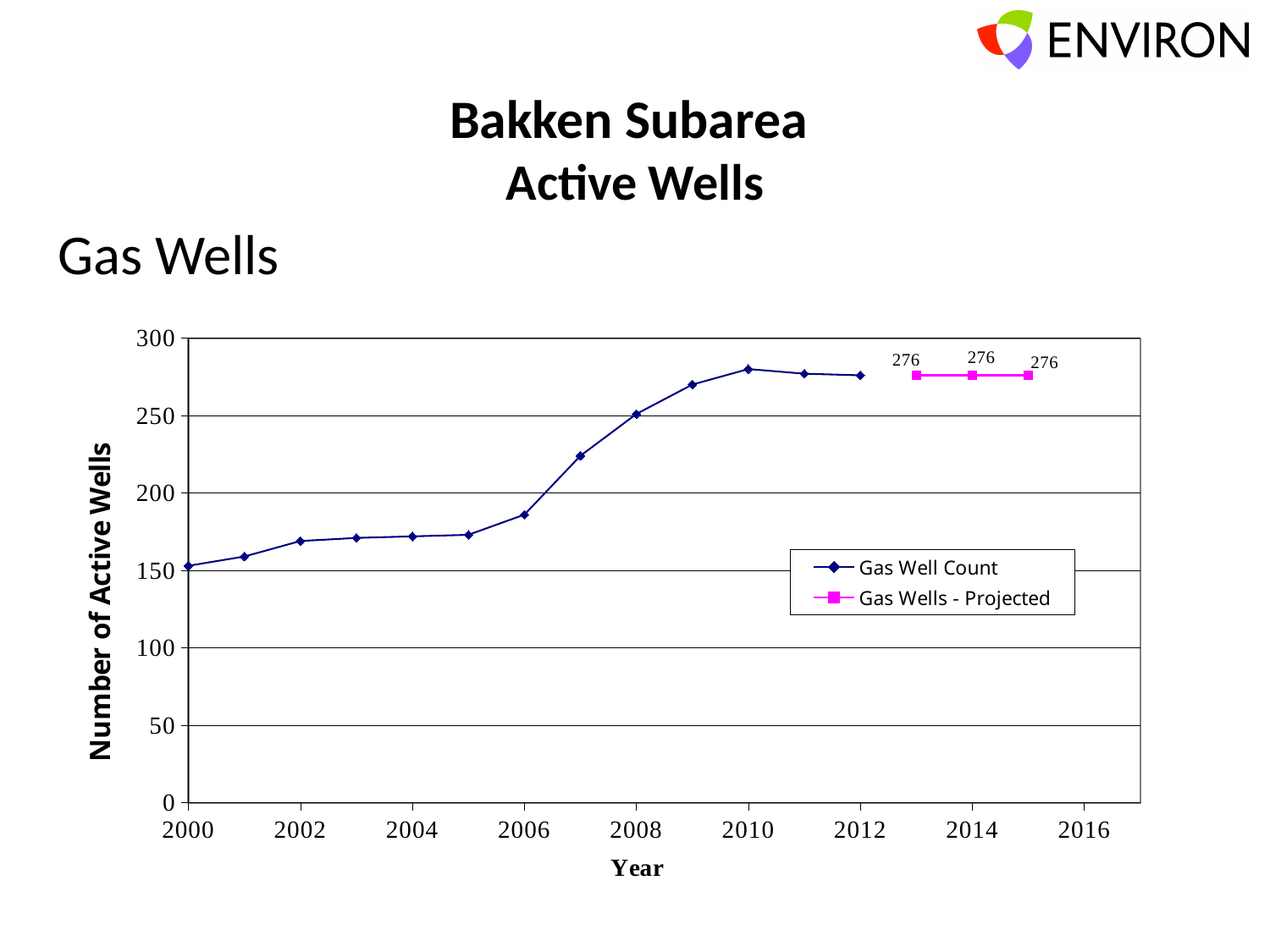
What is the projected number of gas wells for 2014? 276 What type of chart is shown on the slide? line chart Which is larger, the Gas Well Count for 2005 or for 2009? 2009 How many series does the chart legend list? 2 What are the two series named in the legend? Gas Well Count; Gas Wells - Projected Does the Gas Well Count rise or fall from 2000 to 2010? rise Is the Gas Well Count for 2006 greater or less than 200? less Is the Gas Well Count for 2000 greater or less than 200? less Which year has the lowest Gas Well Count? 2000 Is the Gas Well Count for 2010 greater or less than 250? greater What is the projected number of gas wells for 2015? 276 How many data points are plotted for the Gas Wells - Projected series? 3